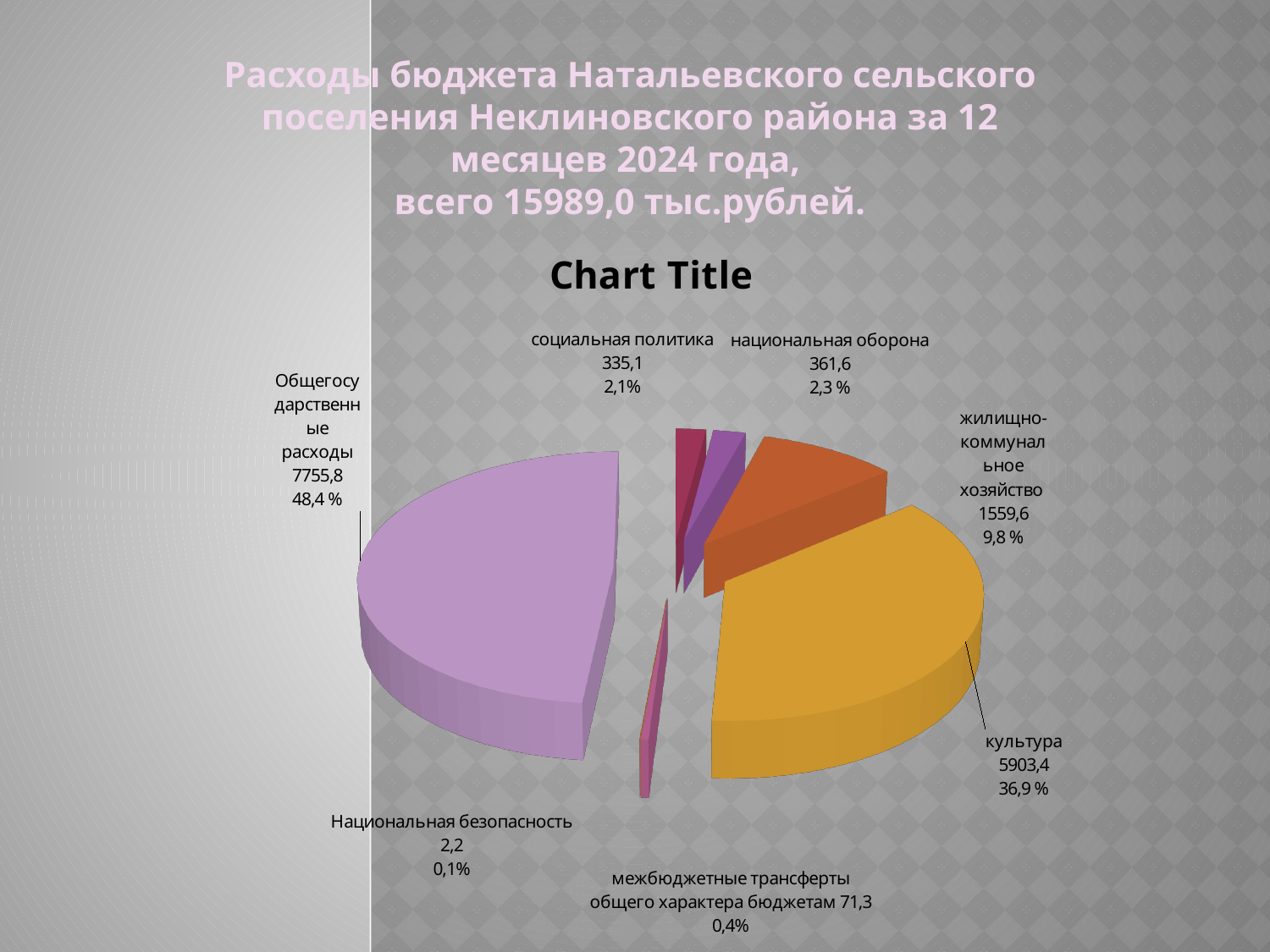
What percentage is shown for национальная оборона? 2,3 % Which category has the smallest slice of the pie? Национальная безопасность Which category has the largest slice of the pie? Общегосударственные расходы What kind of chart is shown on the slide? pie chart How many categories (slices) does the pie chart show? 7 What is the value for жилищно-коммунальное хозяйство? 1559,6 What share of the pie does Общегосударственные расходы take? 48,4 % What is the title printed directly above the pie chart? Chart Title What is the value for межбюджетные трансферты общего характера бюджетам? 71,3 What is the difference between the values for Общегосударственные расходы and культура? 1852,4 Which is larger, социальная политика or национальная оборона? национальная оборона What is the value for культура? 5903,4